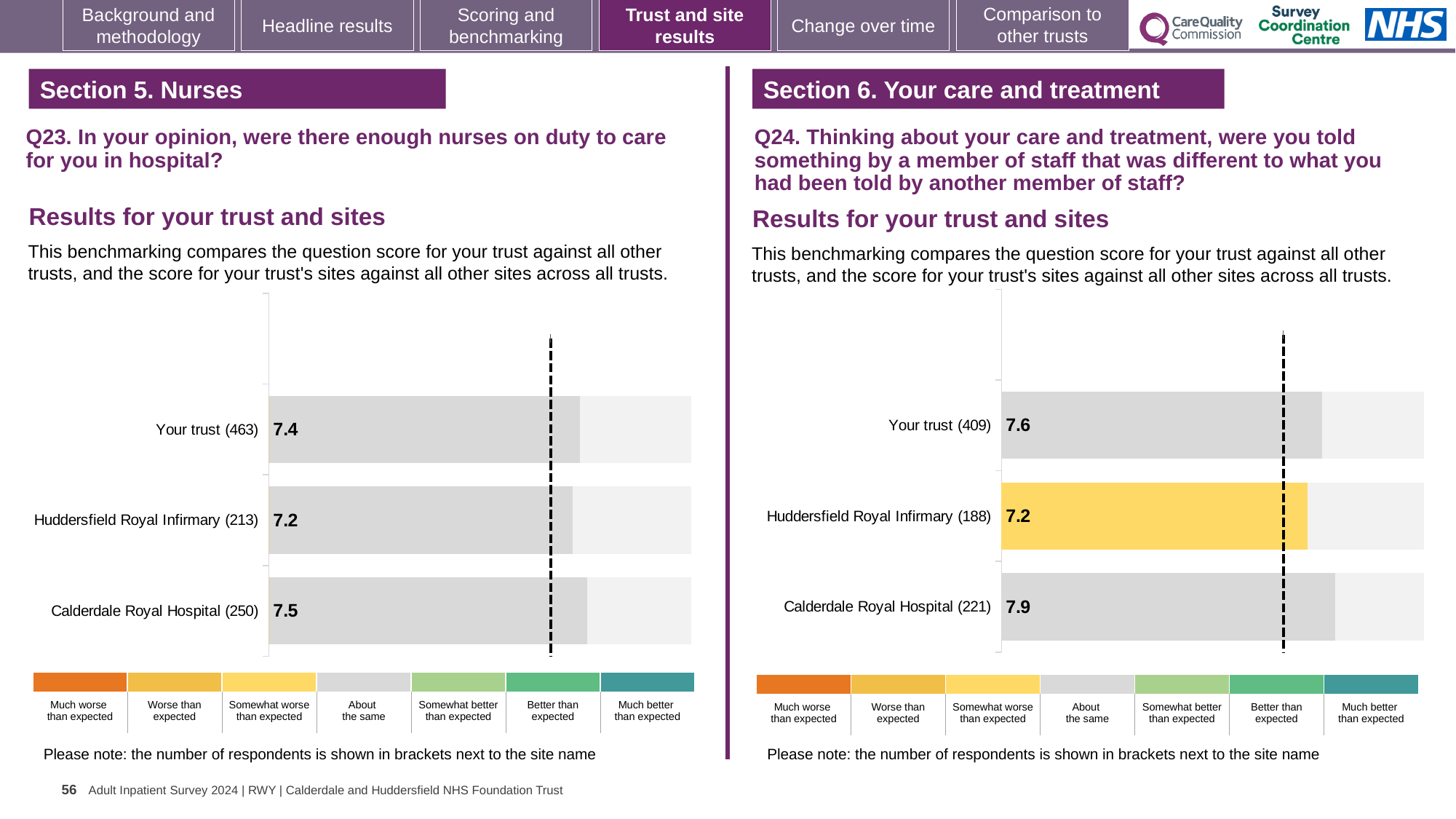
On the Q24 chart (right), which is larger: the score for Your trust or the score for Huddersfield Royal Infirmary? Your trust On the Q23 chart (left), what is the score for Your trust? 7.4 What type of chart is used on the Q23 chart (left)? Bar chart On the Q24 chart (right), how many bars are plotted? 3 On the Q24 chart (right), which benchmark category does the colour of the Huddersfield Royal Infirmary bar indicate? Somewhat worse than expected On the Q23 chart (left), how many respondents are shown for Your trust? 463 On the Q23 chart (left), what is the score for Huddersfield Royal Infirmary? 7.2 On the Q24 chart (right), what is the score for Calderdale Royal Hospital? 7.9 On the Q23 chart (left), what is the difference between the scores for Calderdale Royal Hospital and Huddersfield Royal Infirmary? 0.3 On the Q23 chart (left), which site or trust has the highest score? Calderdale Royal Hospital On the Q24 chart (right), which site or trust has the lowest score? Huddersfield Royal Infirmary On the Q24 chart (right), what is the difference between the scores for Calderdale Royal Hospital and Your trust? 0.3